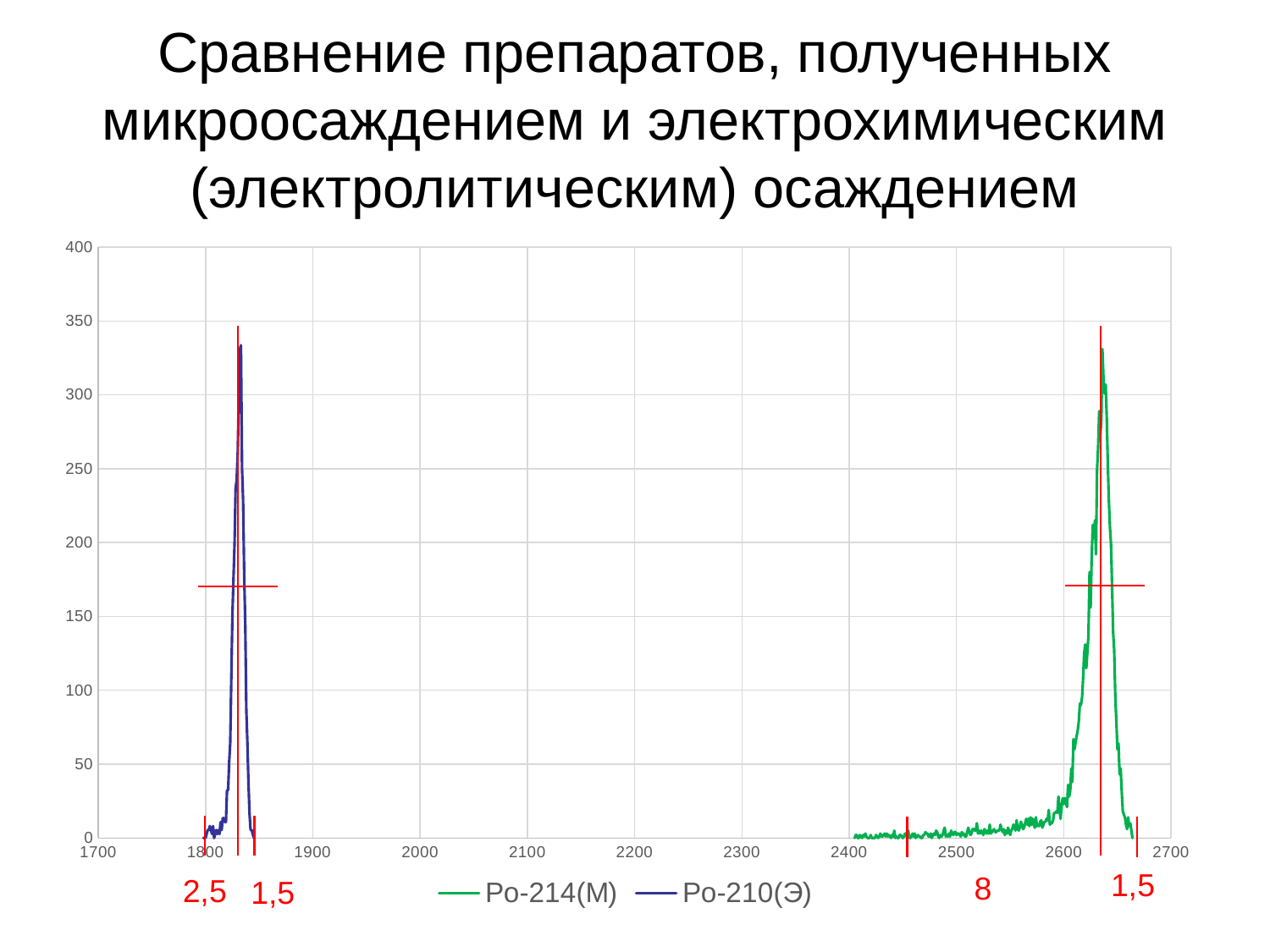
What kind of chart is shown on the slide? line chart Is the peak value of the Po-214(M) series greater or less than 400? less Which series has its peak at a larger x-axis value, Po-214(M) or Po-210(Э)? Po-214(M) Is the peak value of the Po-214(M) series greater or less than 250? greater Is the peak value of the Po-210(Э) series greater or less than 300? greater Which series has its peak at a smaller x-axis value, Po-214(M) or Po-210(Э)? Po-210(Э) What is the maximum value shown on the y axis? 400 How many series does the legend list? 2 Which series is drawn in blue? Po-210(Э) Which series is drawn in green? Po-214(M)